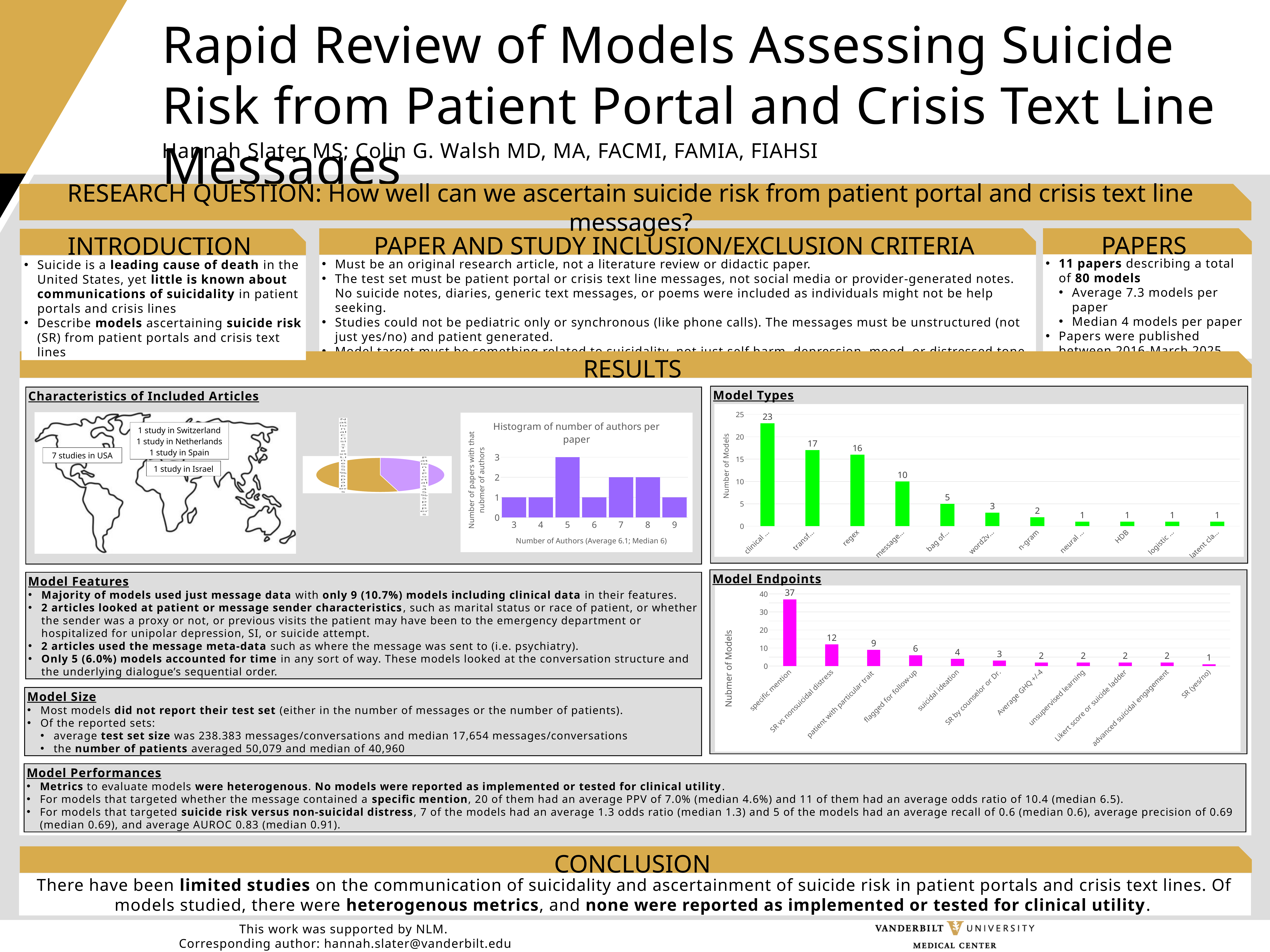
In the Model Endpoints chart, how many endpoint categories are shown? 11 In the Model Endpoints chart, which endpoint has the highest number of models? specific mention What kind of chart is the Model Endpoints chart? bar chart In the Model Types chart, how many models use n-gram? 2 In the Model Endpoints chart, how many models had the endpoint 'SR vs nonsuicidal distress'? 12 In the Model Types chart, which of 'regex' or 'HDB' has more models? regex In the Model Endpoints chart, what is the difference between the number of models for 'specific mention' and 'SR vs nonsuicidal distress'? 25 In the Model Endpoints chart, how many models had the endpoint 'specific mention'? 37 In the Histogram of number of authors per paper, how many papers had 5 authors? 3 In the Model Endpoints chart, which endpoint has the lowest number of models? SR (yes/no) In the Model Types chart, what is the value of the tallest bar? 23 In the Model Types chart, how many models use regex? 16